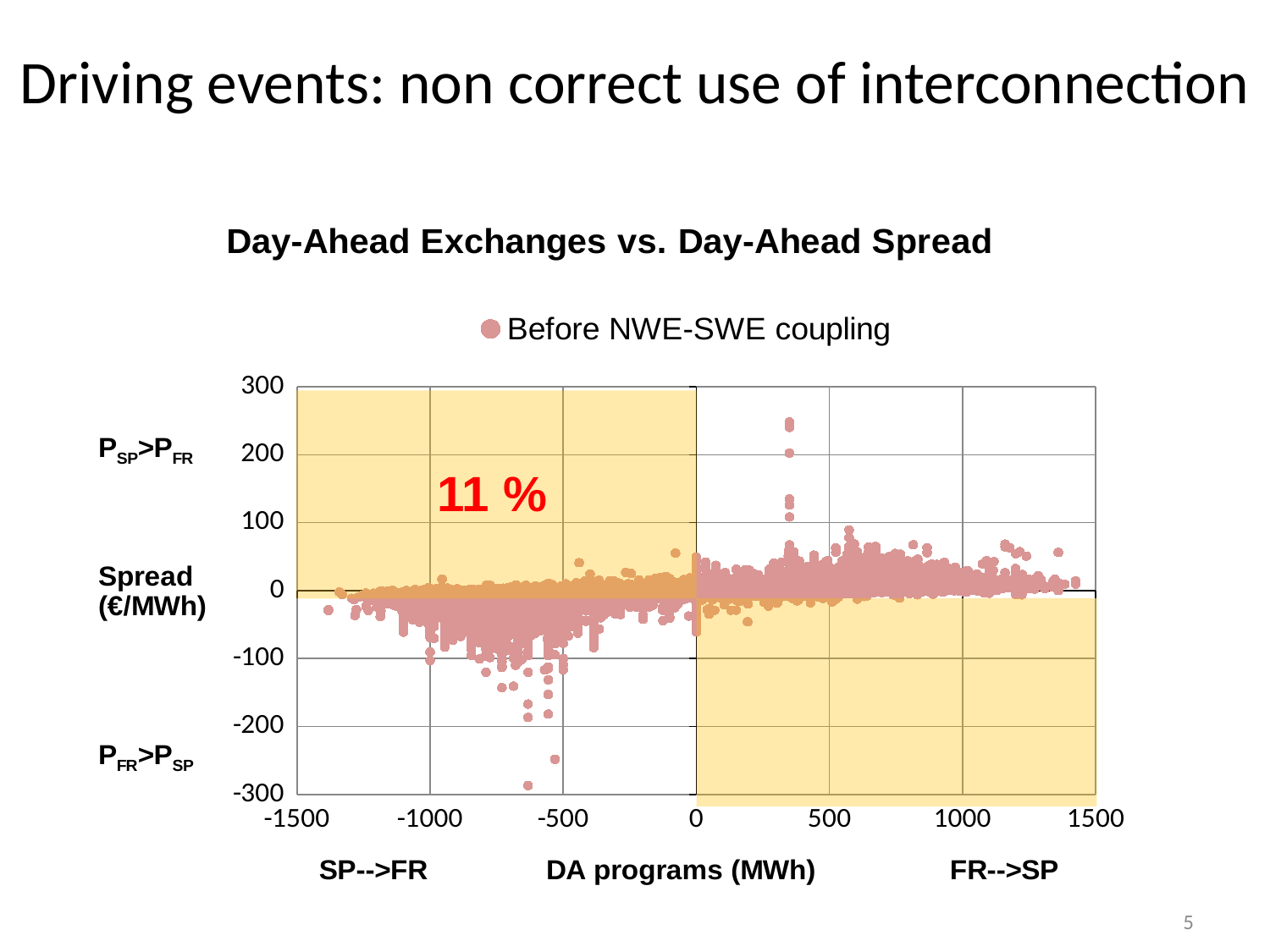
What is the legend entry for the plotted series? Before NWE-SWE coupling Is the highest spread value plotted on the chart greater or less than 200? greater Is the lowest spread value plotted on the chart greater or less than -200? less What percentage is printed in the shaded upper-left region of the chart? 11 % How many series does the legend list? 1 What kind of chart is shown on the slide? scatter chart What is the title of the chart? Day-Ahead Exchanges vs. Day-Ahead Spread